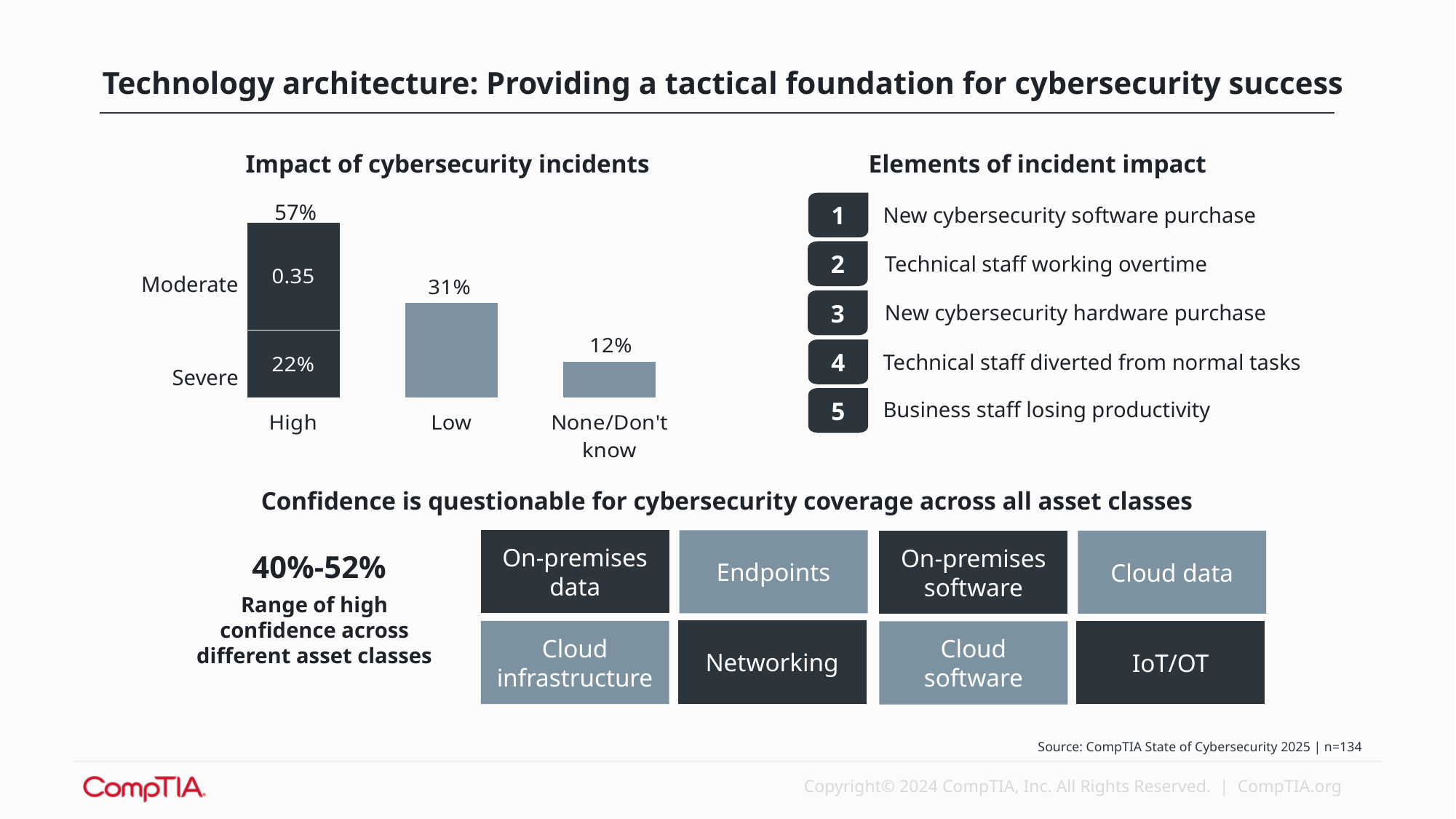
In the 'Impact of cybersecurity incidents' chart, what value is printed on the Moderate segment of the High bar? 0.35 How many categories are shown on the x axis of the 'Impact of cybersecurity incidents' chart? 3 In the 'Impact of cybersecurity incidents' chart, which category has the lowest value? None/Don't know In the 'Impact of cybersecurity incidents' chart, what is the difference between the Low value and the None/Don't know value? 19 percentage points In the 'Impact of cybersecurity incidents' chart, which is larger: Low or None/Don't know? Low In the 'Impact of cybersecurity incidents' chart, what is the difference between the High total and the Low value? 26 percentage points In the 'Impact of cybersecurity incidents' chart, which category has the highest value? High In the 'Impact of cybersecurity incidents' chart, what is the value for Low? 31% In the 'Impact of cybersecurity incidents' chart, what is the total shown above the stacked High bar? 57% In the 'Impact of cybersecurity incidents' chart, what value is shown for the Severe segment of the High bar? 22% In the 'Impact of cybersecurity incidents' chart, what is the value for None/Don't know? 12% What kind of chart is 'Impact of cybersecurity incidents'? Bar chart